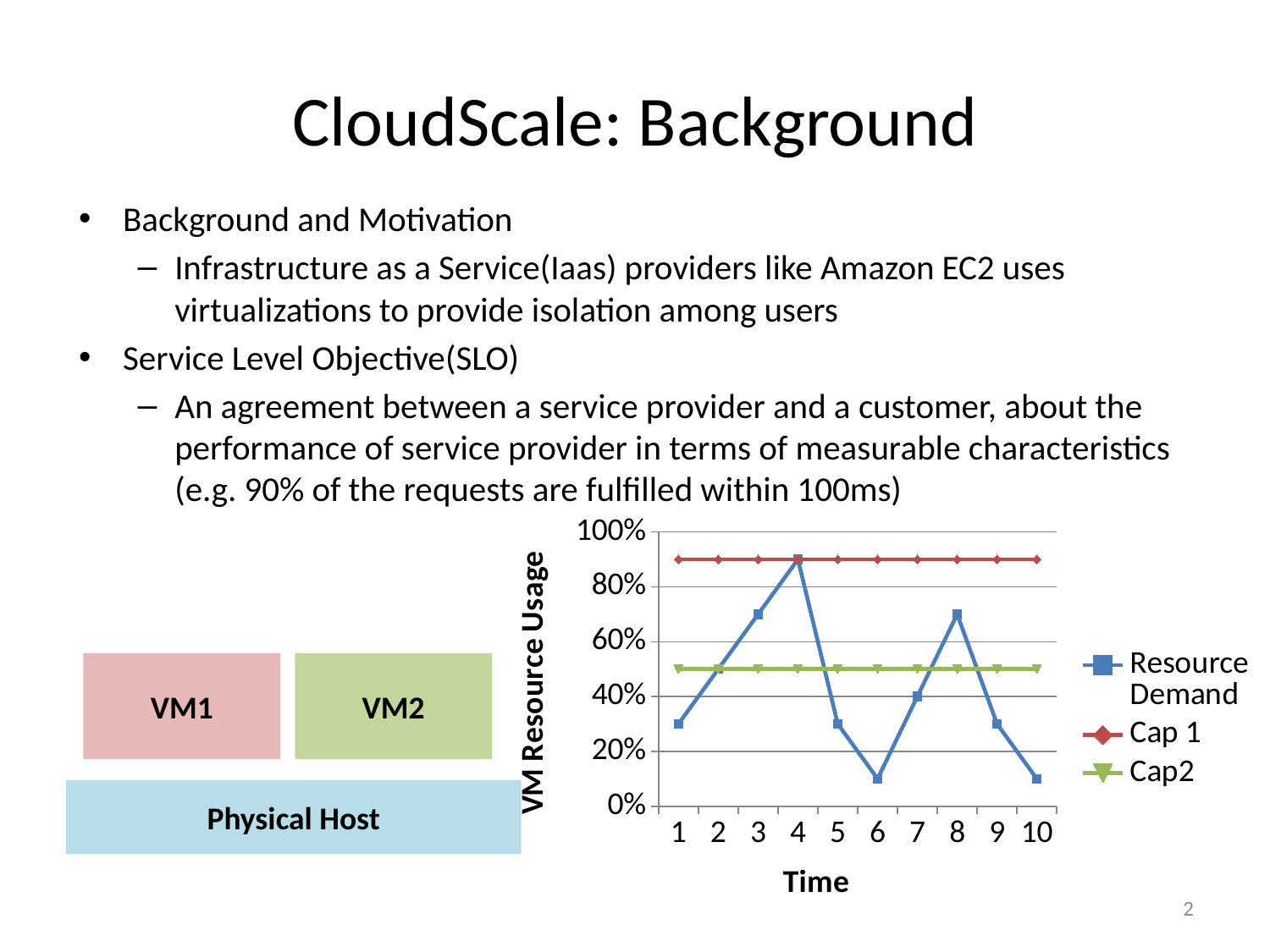
Is the Resource Demand value at time 6 greater or less than 20%? less Is the Resource Demand value at time 4 greater or less than 80%? greater Is the Cap2 line greater or less than 60%? less What kind of chart is shown on the slide? line chart How many time points are plotted along the x axis of the chart? 10 How many series does the chart's legend list? 3 What is the title of the chart's x axis? Time At which time point does the Resource Demand series reach its highest value? 4 Which series has the higher constant value, Cap 1 or Cap2? Cap 1 Is the Resource Demand value larger at time 3 or at time 5? time 3 Does the Resource Demand series rise or fall from time 1 to time 4? rise